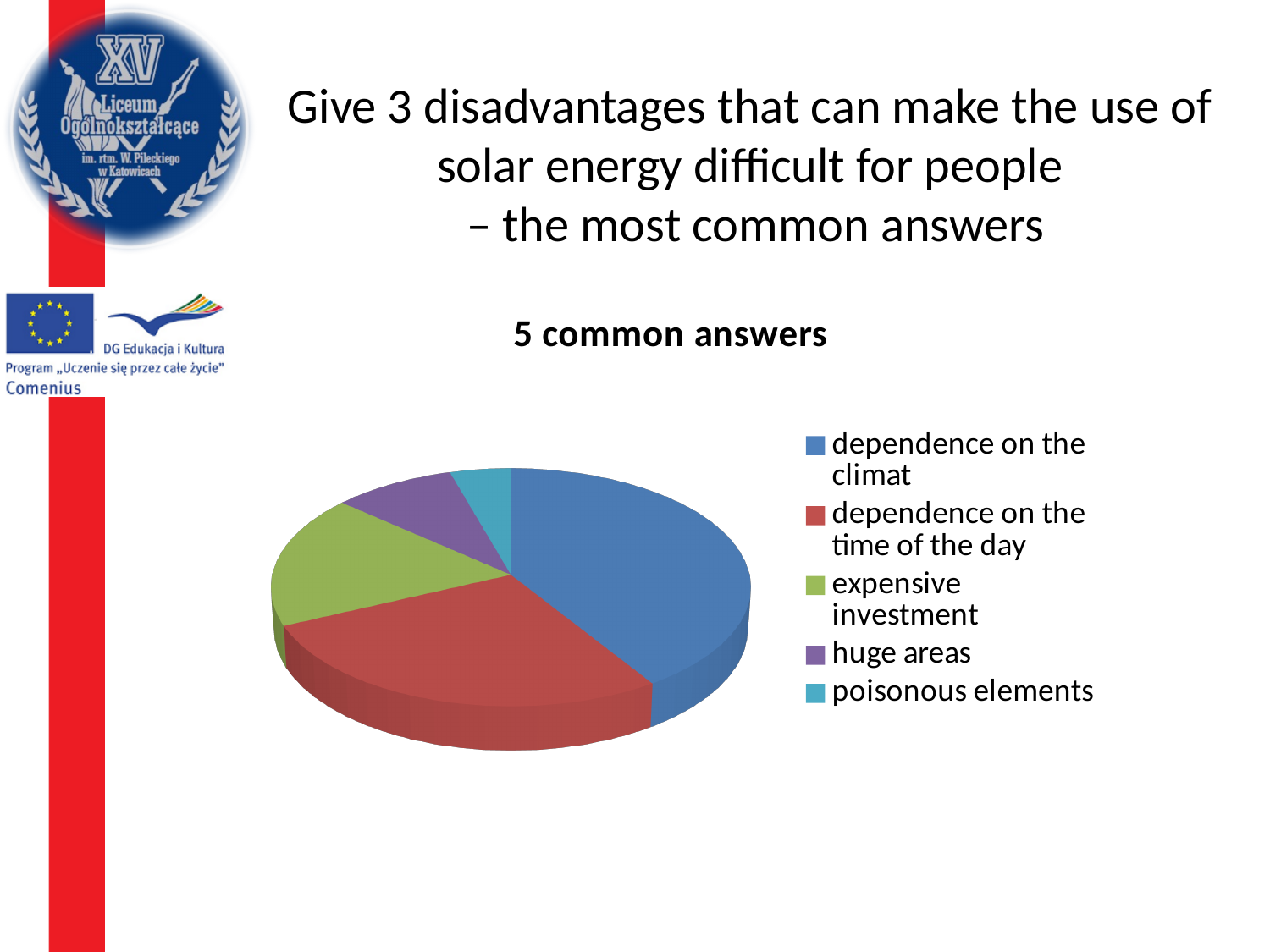
Which slice is larger: huge areas or poisonous elements? huge areas How many slices does the pie chart have? 5 What colour is the slice for expensive investment? green Which category has the smallest slice of the pie? poisonous elements Which slice is larger: dependence on the time of the day or expensive investment? dependence on the time of the day How many entries does the chart legend list? 5 Which slice is larger: dependence on the climat or dependence on the time of the day? dependence on the climat What is the title of the chart? 5 common answers Which category has the largest slice of the pie? dependence on the climat What kind of chart is shown on the slide? pie chart